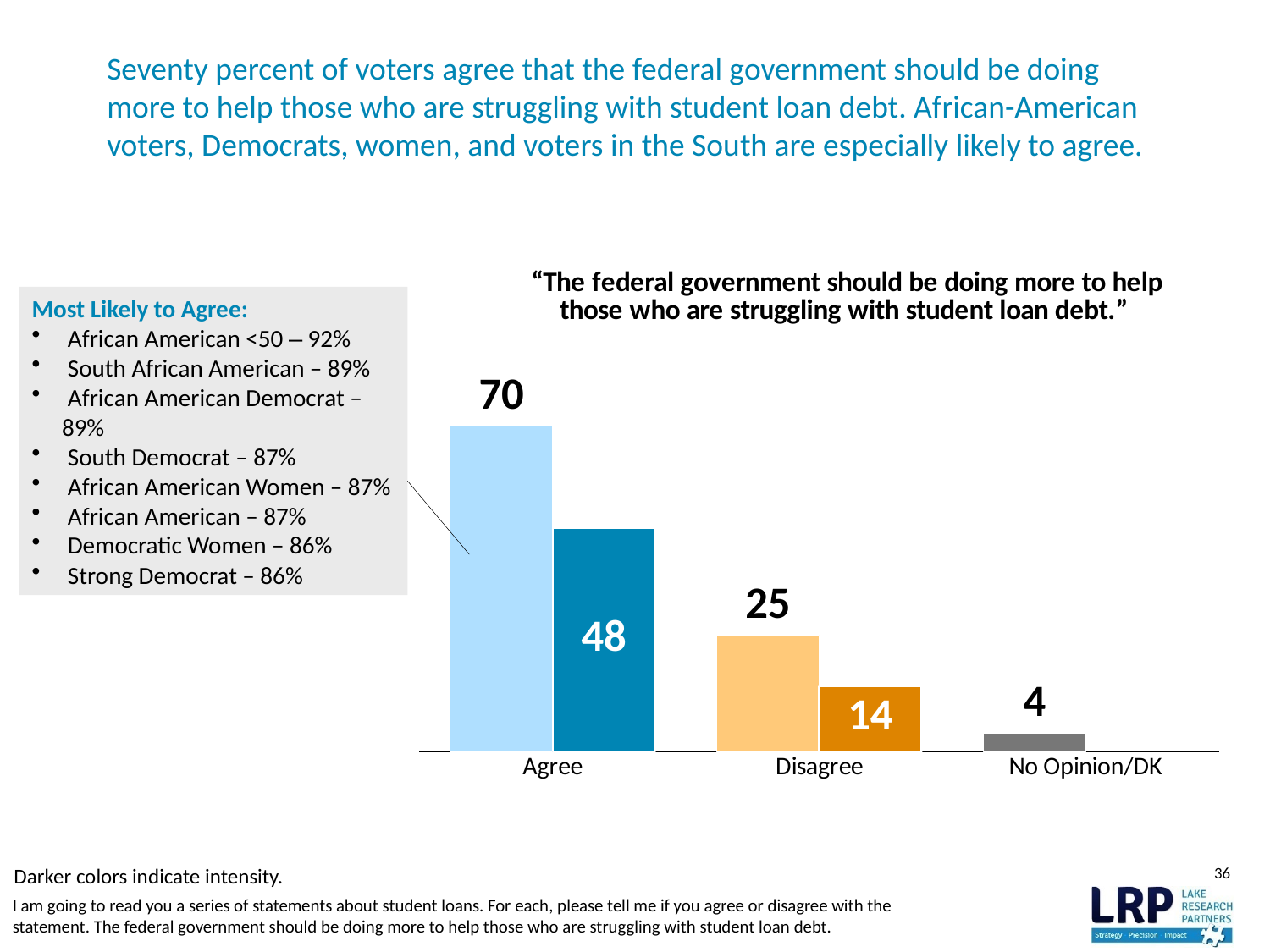
What value is printed on the darker bar within the Disagree category? 14 Which is larger, the value for Disagree or the value for No Opinion/DK? Disagree What is the value shown for No Opinion/DK in the chart? 4 What is the difference between the Agree value (70) and the Disagree value (25)? 45 What is the value shown for Disagree in the chart? 25 Which category has the lowest value in the chart? No Opinion/DK What value is printed on the darker bar within the Agree category? 48 What is the difference between the darker Agree bar (48) and the darker Disagree bar (14)? 34 How many categories are shown on the x axis of the chart? 3 Which category has the highest value in the chart? Agree What is the value shown for Agree in the chart? 70 What type of chart is shown on the slide? Bar chart